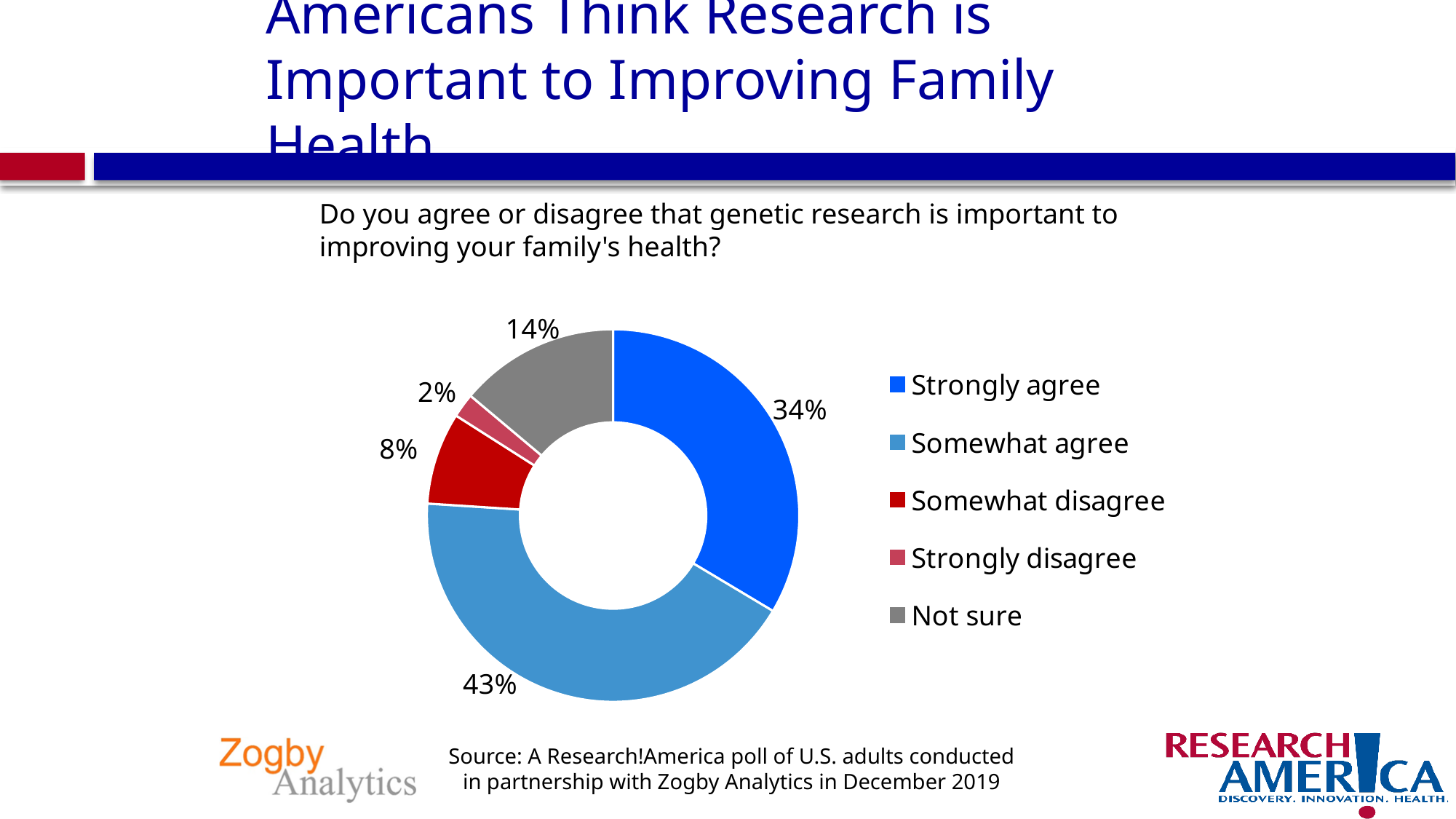
Which response category has the smallest share of the chart? Strongly disagree Which response category has the largest share of the chart? Somewhat agree What percentage of respondents somewhat agree? 43% How many response categories does the chart show? 5 Which is larger, the share for 'Not sure' or the share for 'Somewhat disagree'? Not sure What percentage of respondents answered 'Not sure'? 14% What percentage of respondents somewhat disagree? 8% What percentage of respondents strongly agree that genetic research is important to improving their family's health? 34% What percentage of respondents strongly disagree? 2% What colour represents 'Not sure' in the chart? Gray What is the difference in percentage points between 'Somewhat agree' and 'Strongly agree'? 9 What kind of chart is shown on the slide? Pie chart (donut)